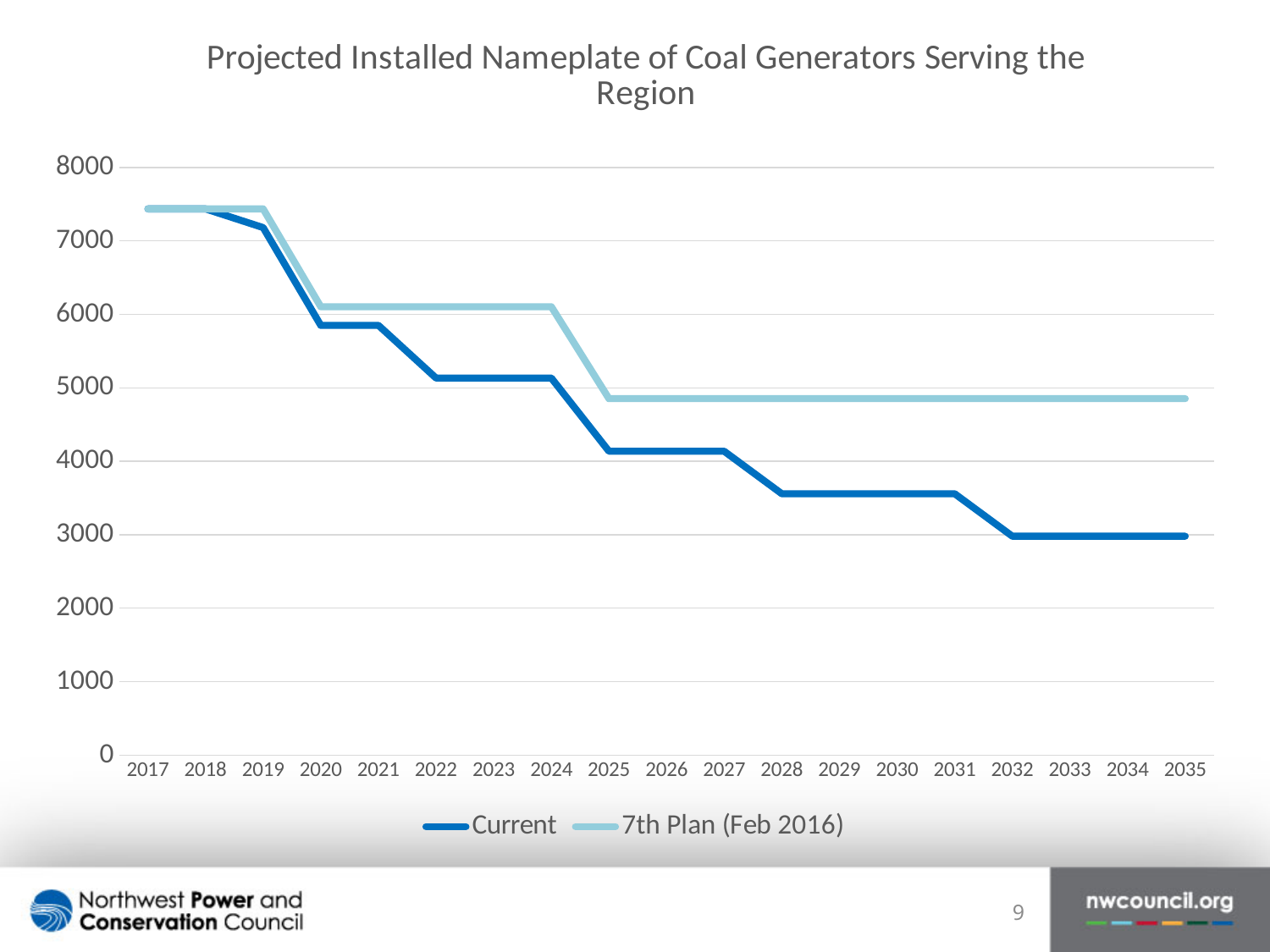
What kind of chart is shown on the slide? Line chart Do the values of the Current series rise or fall from 2017 to 2035? Fall In 2030, which series has the higher value, Current or 7th Plan (Feb 2016)? 7th Plan (Feb 2016) What is the title of the chart? Projected Installed Nameplate of Coal Generators Serving the Region Is the value for the Current series in 2017 greater or less than 7000? greater How many series does the legend list? 2 Is the value for the Current series in 2028 greater or less than 4000? less How many years are shown on the x axis? 19 Is the value for the Current series in 2020 greater or less than 6000? less What is the first year shown on the x axis? 2017